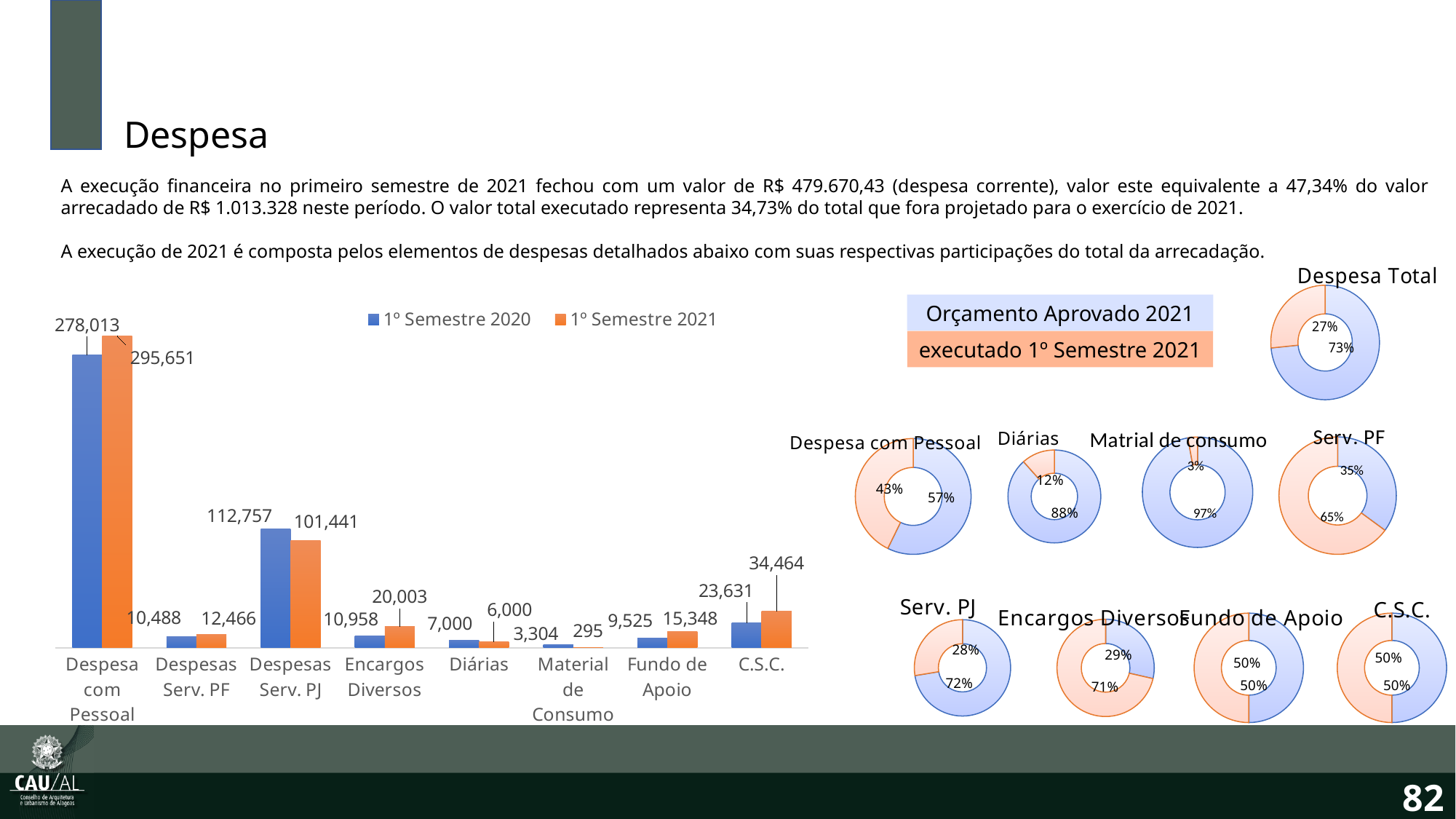
In the bar chart, what is the value for Despesa com Pessoal in 1º Semestre 2021? 295,651 In the bar chart, what is the difference between the 1º Semestre 2021 and 1º Semestre 2020 values for C.S.C.? 10,833 How many series does the legend of the bar chart list? 2 In the Despesa Total donut chart, what percentage is shown for the larger slice? 73% In the bar chart, which category has the lowest value in 1º Semestre 2020? Material de Consumo In the bar chart, what is the value for Despesas Serv. PJ in 1º Semestre 2020? 112,757 What kind of chart is the chart on the left of the slide? Bar chart In the Diárias donut chart, what percentage is shown for the smaller slice? 12% How many categories are shown on the x axis of the bar chart? 8 In the bar chart, what is the value for Material de Consumo in 1º Semestre 2021? 295 In the bar chart, which is larger for Diárias: the 1º Semestre 2020 value or the 1º Semestre 2021 value? 1º Semestre 2020 In the bar chart, which category has the highest value in 1º Semestre 2021? Despesa com Pessoal